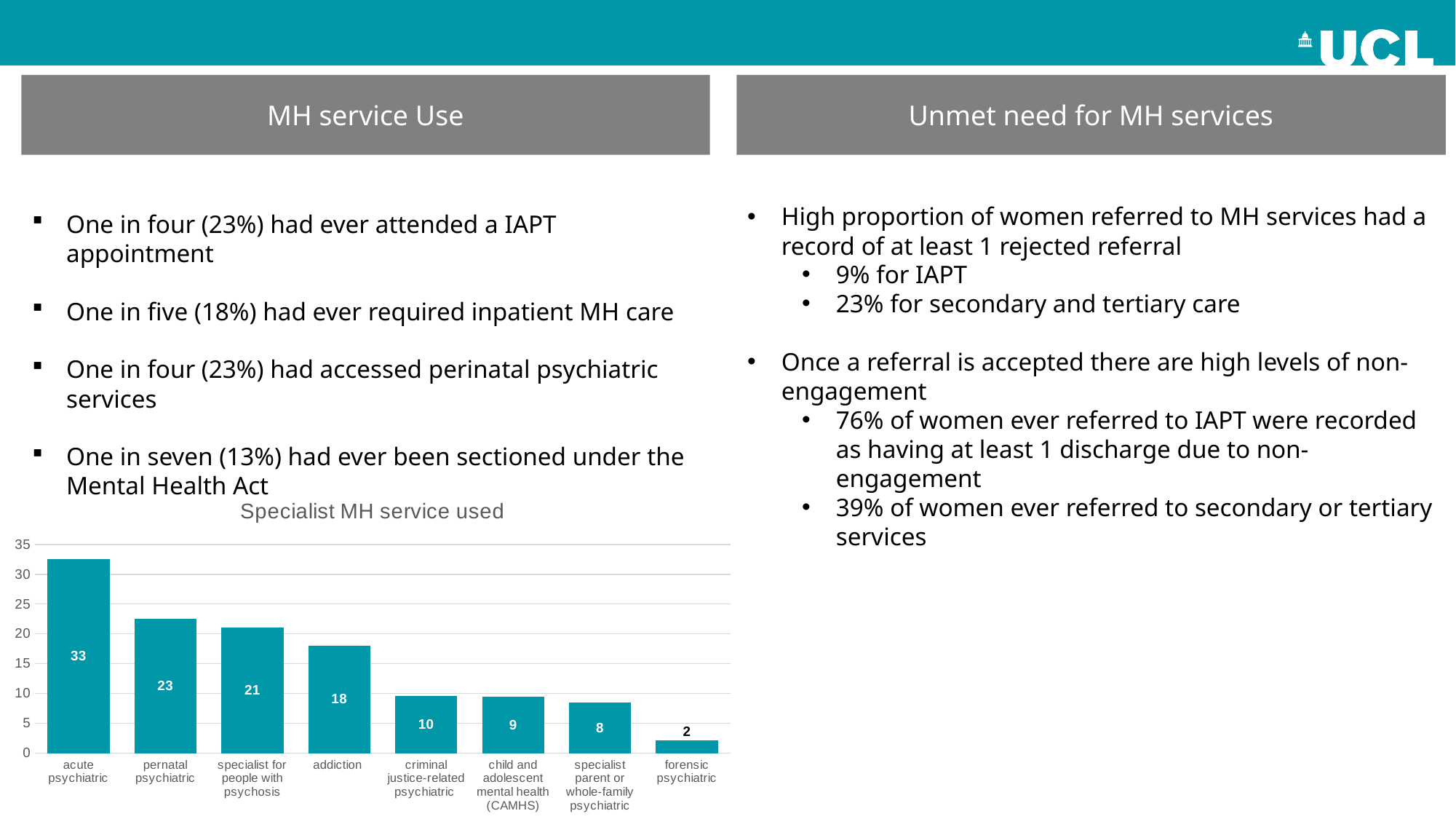
What is the value for addiction in the Specialist MH service used chart? 18 What is the difference between the values for acute psychiatric and pernatal psychiatric in the Specialist MH service used chart? 10 What kind of chart is the Specialist MH service used chart? bar chart Which category has the lowest value in the Specialist MH service used chart? forensic psychiatric How many categories are shown in the Specialist MH service used chart? 8 What is the value for acute psychiatric in the Specialist MH service used chart? 33 Is the value for criminal justice-related psychiatric greater or less than 15 in the Specialist MH service used chart? less Which is larger in the Specialist MH service used chart: specialist for people with psychosis or addiction? specialist for people with psychosis Do the values in the Specialist MH service used chart rise or fall from left to right? fall Which category has the highest value in the Specialist MH service used chart? acute psychiatric What is the value for forensic psychiatric in the Specialist MH service used chart? 2 What is the title of the chart on the slide? Specialist MH service used